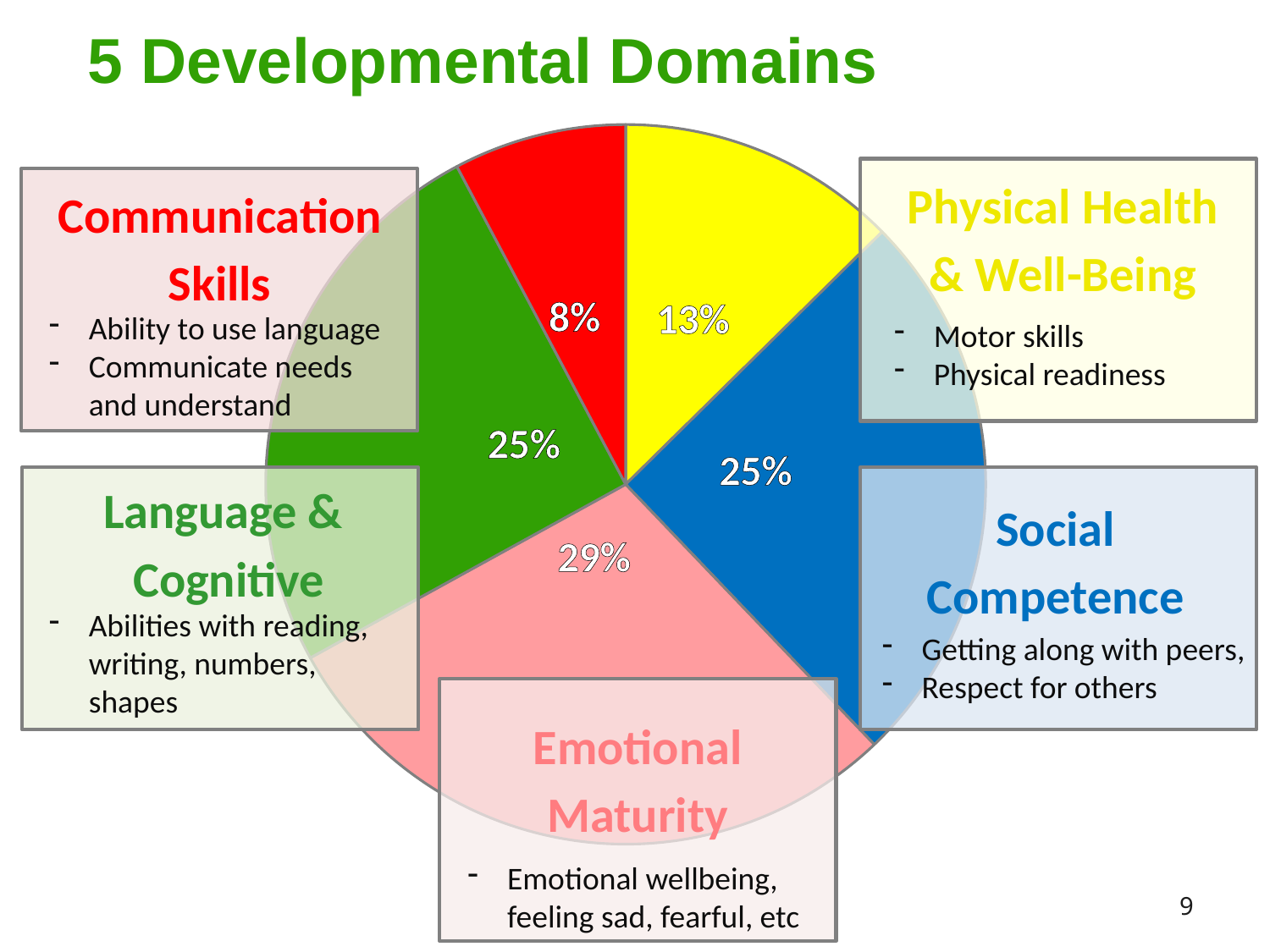
How many slices does the pie chart have? 5 What is the title of the slide containing the pie chart? 5 Developmental Domains What is the combined percentage of the Social Competence and Language & Cognitive slices? 50% What percentage is shown for the Emotional Maturity (pink) slice? 29% Which domain has the largest slice of the pie chart? Emotional Maturity What is the difference in percentage points between the Emotional Maturity slice and the Communication Skills slice? 21 What percentage is shown for the Social Competence (blue) slice? 25% Which domain has the smallest slice of the pie chart? Communication Skills What percentage is shown for the Communication Skills (red) slice? 8% Which is larger, the Physical Health & Well-Being slice or the Language & Cognitive slice? Language & Cognitive What percentage is shown for the Physical Health & Well-Being (yellow) slice? 13% What kind of chart is shown on the slide? pie chart